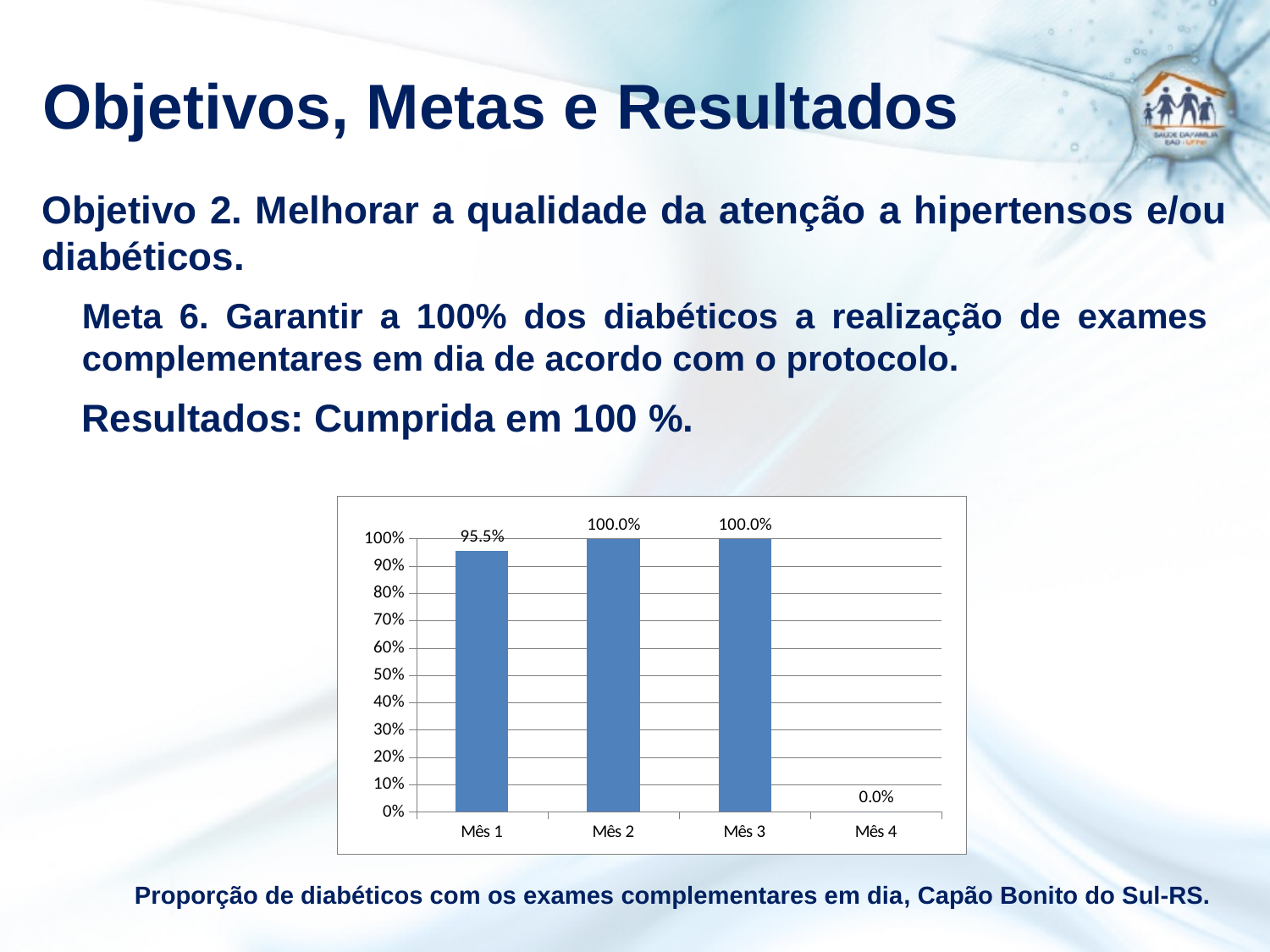
Do the values rise or fall from Mês 1 to Mês 2? rise What is the value for Mês 1? 95.5% What is the difference between the values for Mês 3 and Mês 4? 100.0% What kind of chart is shown on the slide? bar chart Which category has the lowest value? Mês 4 What is the difference between the values for Mês 2 and Mês 1? 4.5% What is the value for Mês 2? 100.0% Is the value for Mês 1 greater or less than 90%? greater Which is larger, the value for Mês 1 or the value for Mês 3? Mês 3 What is the value for Mês 4? 0.0% How many categories are shown on the x axis? 4 What is the caption below the chart? Proporção de diabéticos com os exames complementares em dia, Capão Bonito do Sul-RS.